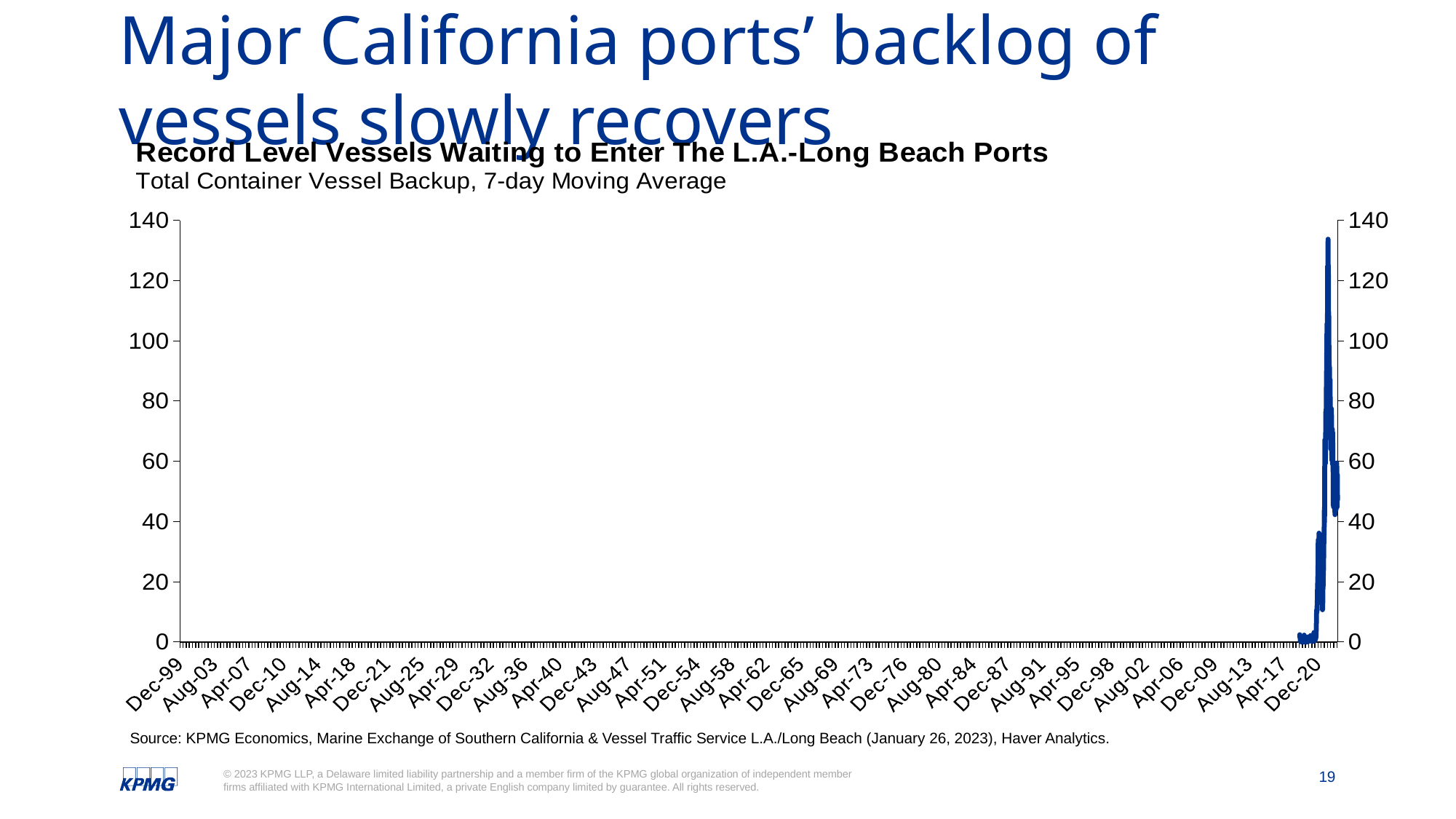
What is the title of the chart? Record Level Vessels Waiting to Enter The L.A.-Long Beach Ports Is the value of the line at the Dec-99 end of the x axis greater or less than 20? less What is the highest value shown on the y axis? 140 Is the final value of the line at the right end of the chart greater or less than 20? greater Is the final value of the line at the right end of the chart greater or less than 60? less What is the first label on the x axis? Dec-99 What is the subtitle printed under the chart title? Total Container Vessel Backup, 7-day Moving Average How many lines (series) are plotted on the chart? 1 What kind of chart is shown on the slide? Line chart Does the line stay near zero or rise sharply toward the right end of the x axis? Rises sharply toward the right end